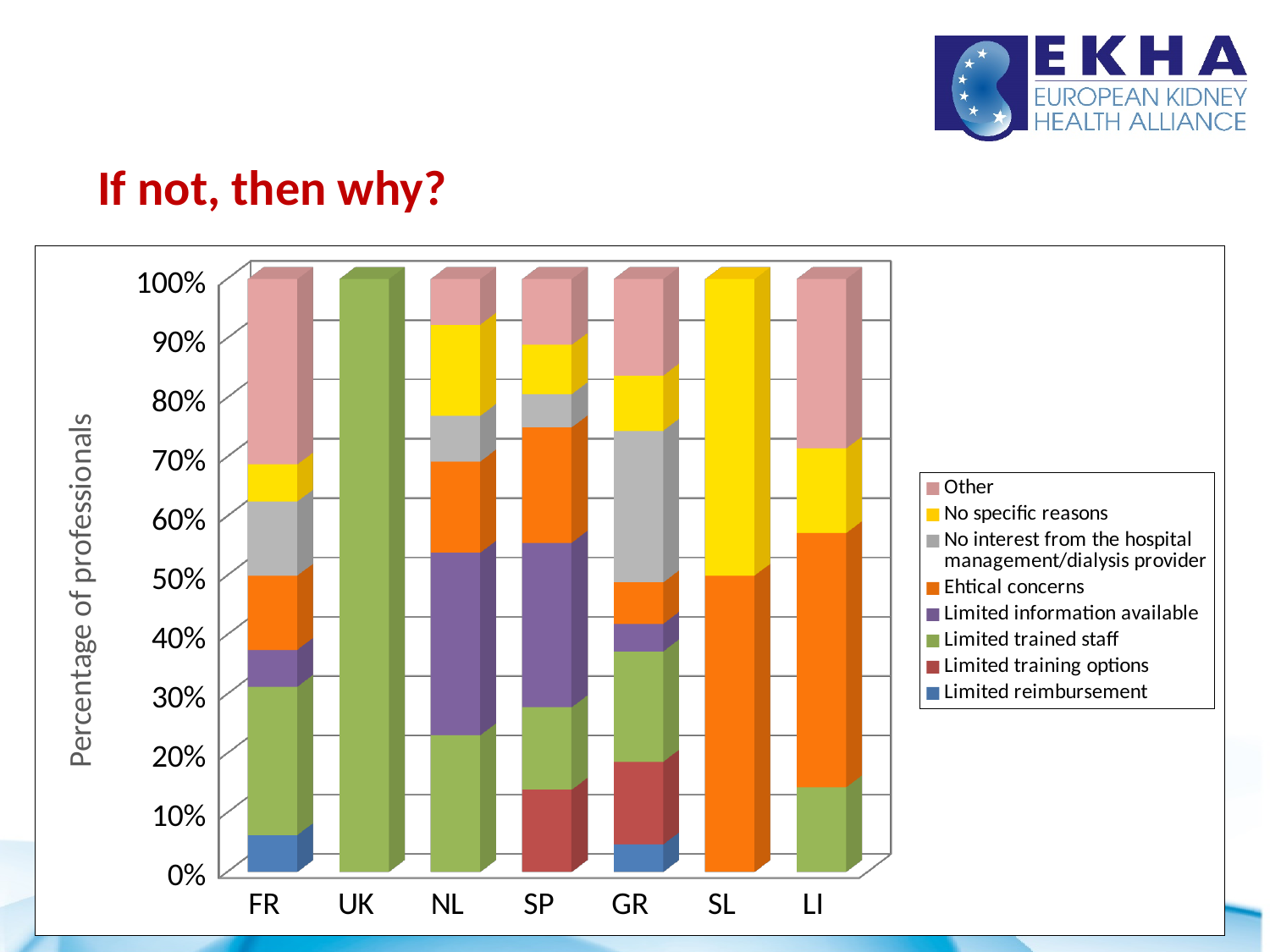
What kind of chart is shown on the slide? Stacked bar chart Which country has the largest share for Limited trained staff? UK Which country has the largest share for No specific reasons? SL How many series does the legend list? 8 What is the label on the vertical axis of the chart? Percentage of professionals Is the share for Limited trained staff in FR greater or less than 20%? greater What is the title of the slide above the chart? If not, then why? How many countries are shown along the x axis of the chart? 7 How many countries have a Limited reimbursement segment in their bar? 2 Is the share for Ethical concerns in LI greater or less than 30%? greater Is the share for Ethical concerns in SL greater or less than 40%? greater What percentage of professionals in the UK cited Limited trained staff? 100%